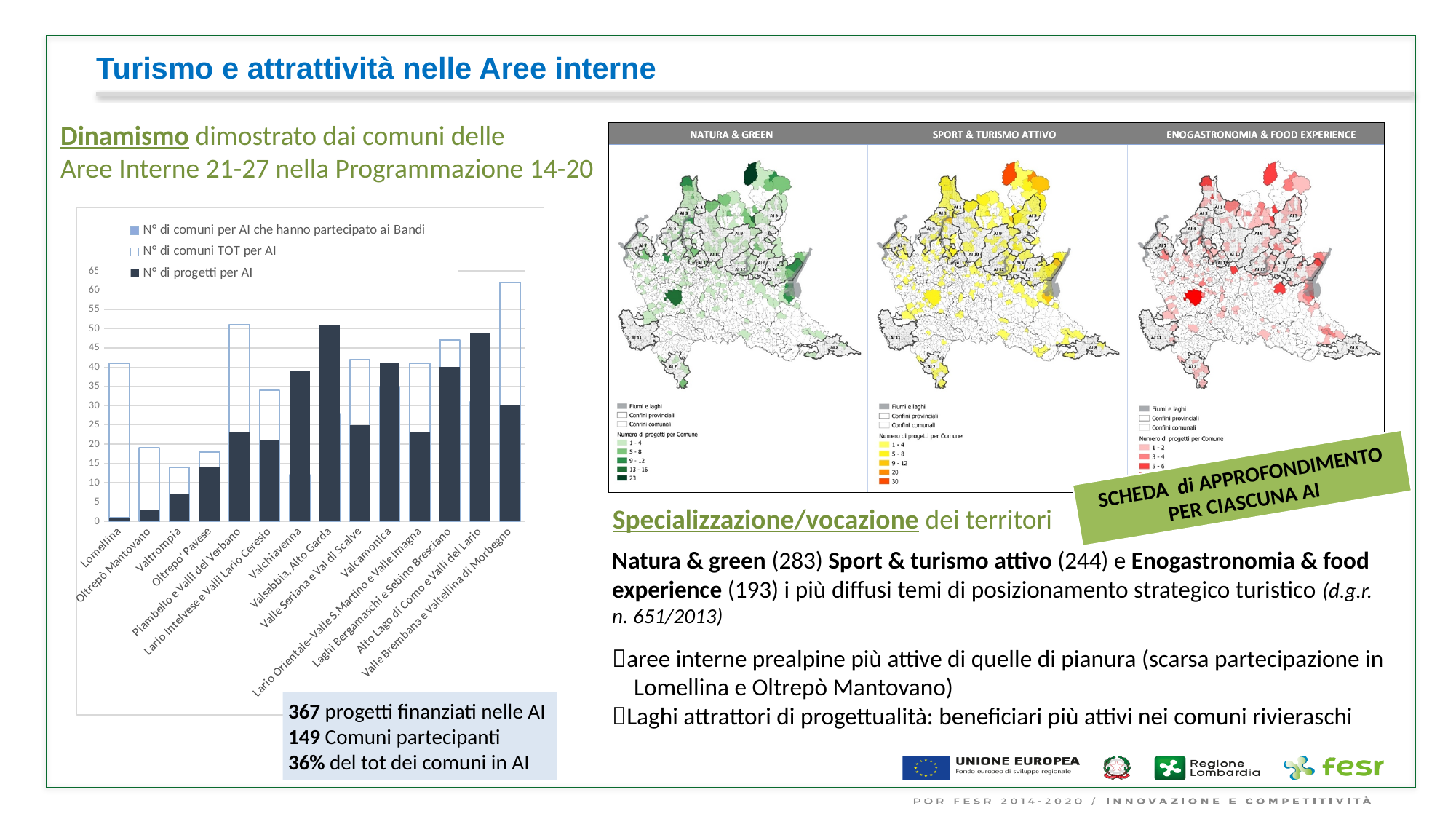
In the bar chart, which category has the lowest value for 'N° di progetti per AI'? Lomellina What kind of chart is shown on the left of the slide? bar chart In the bar chart, is the value of 'N° di progetti per AI' for Lomellina greater or less than 5? less In the bar chart, which category has the highest value for 'N° di comuni TOT per AI'? Valle Brembana e Valtellina di Morbegno In the bar chart, which has a higher 'N° di comuni TOT per AI': Lomellina or Oltrepò Mantovano? Lomellina In the bar chart, is the value of 'N° di comuni TOT per AI' for Piambello e Valli del Verbano greater or less than 45? greater In the bar chart, is the value of 'N° di comuni TOT per AI' for Lomellina greater or less than 35? greater How many series does the legend of the bar chart list? 3 In the bar chart, which has more 'N° di progetti per AI': Valchiavenna or Valtrompia? Valchiavenna In the bar chart legend, which series is represented by the dark filled bars? N° di progetti per AI How many categories (Aree Interne) are shown on the x axis of the bar chart? 14